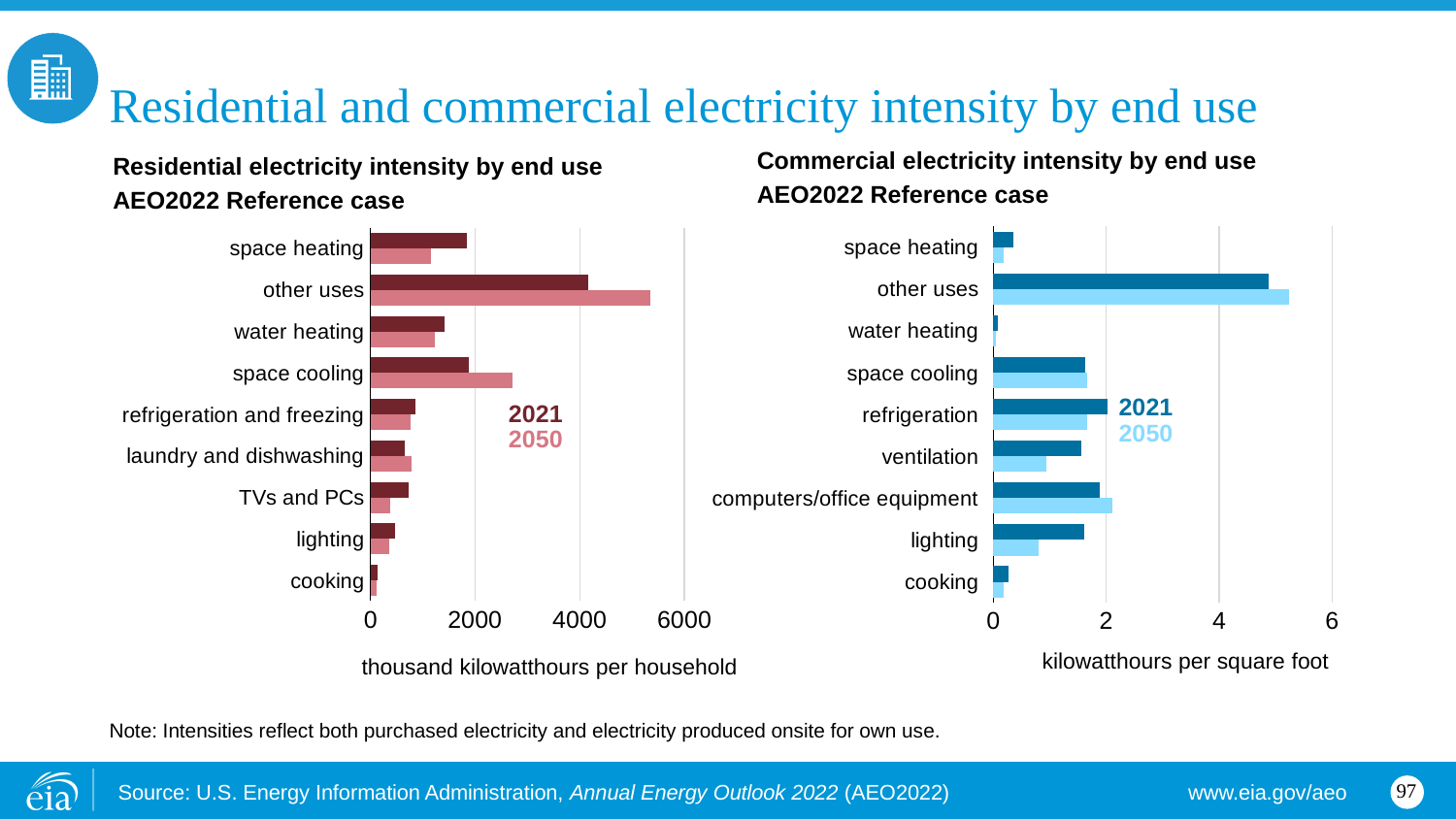
How many end-use categories does the residential electricity intensity chart on the left show? 9 In the commercial electricity intensity chart on the right, which end use has the lowest value in 2021? water heating In the residential electricity intensity chart on the left, which end use has the highest value in 2050? other uses In the residential electricity intensity chart on the left, is the 2050 value for other uses greater or less than 4000? greater In the commercial electricity intensity chart on the right, is the 2050 value for lighting greater or less than 2? less In the commercial electricity intensity chart on the right, is the 2021 value for other uses greater or less than 4? greater What unit is shown on the x axis of the commercial electricity intensity chart on the right? kilowatthours per square foot What kind of chart is the residential electricity intensity chart on the left? bar chart In the commercial electricity intensity chart on the right, which is larger for ventilation: the 2021 value or the 2050 value? 2021 How many series does the legend of the commercial electricity intensity chart on the right list? 2 In the residential electricity intensity chart on the left, which is larger for space cooling: the 2021 value or the 2050 value? 2050